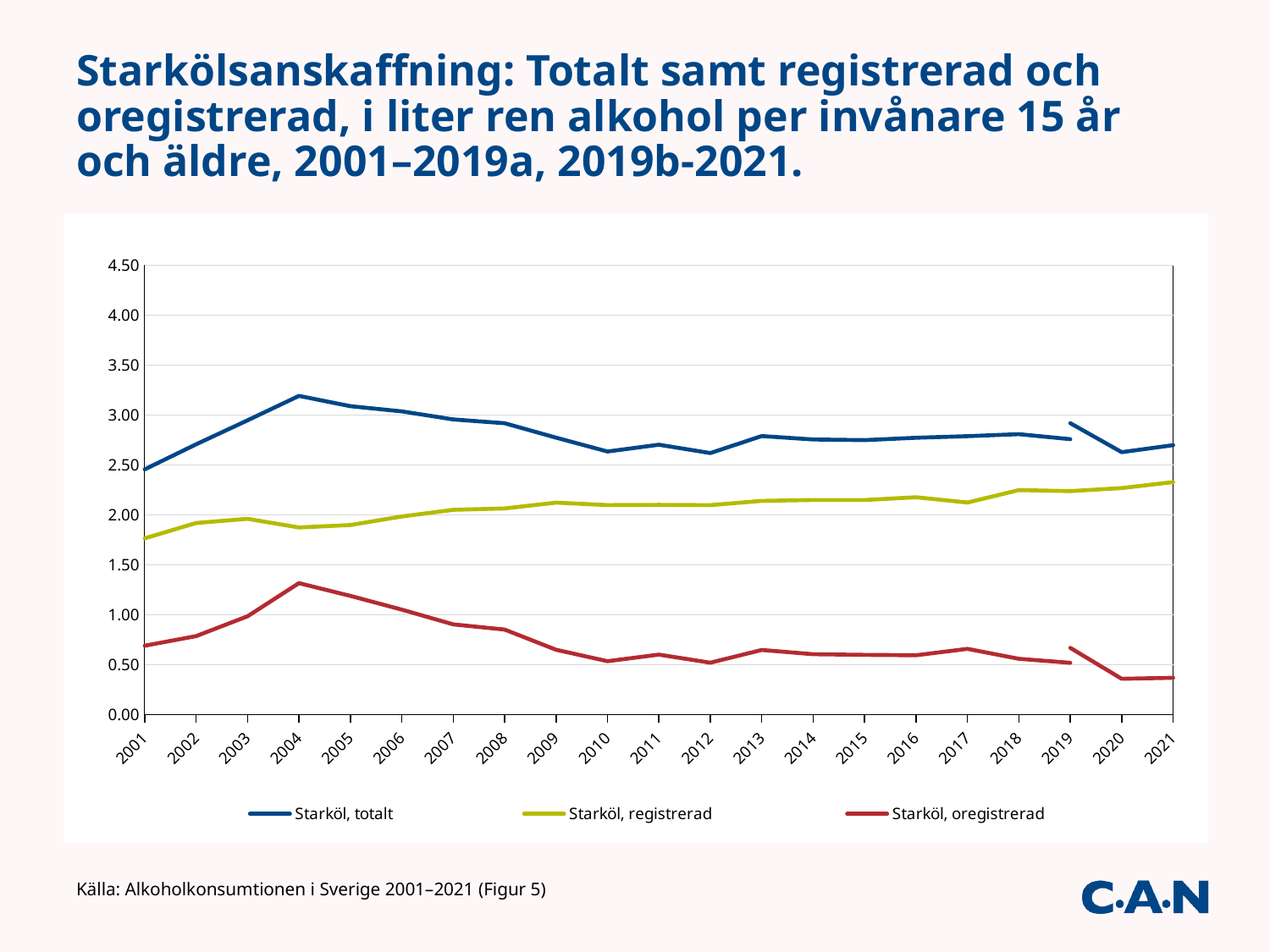
Is the value for Starköl, oregistrerad in 2020 greater or less than 0.50? less Which series is drawn with the blue line? Starköl, totalt Is the value for Starköl, registrerad in 2001 greater or less than 2.00? less How many series does the legend list? 3 In which year is Starköl, totalt at its highest? 2004 Which is larger in 2010, Starköl, registrerad or Starköl, oregistrerad? Starköl, registrerad Does Starköl, oregistrerad rise or fall between 2004 and 2010? fall In which year is Starköl, oregistrerad at its highest? 2004 How many years are shown on the x axis? 21 Is the value for Starköl, totalt in 2010 greater or less than 3.00? less What kind of chart is shown on the slide? line chart